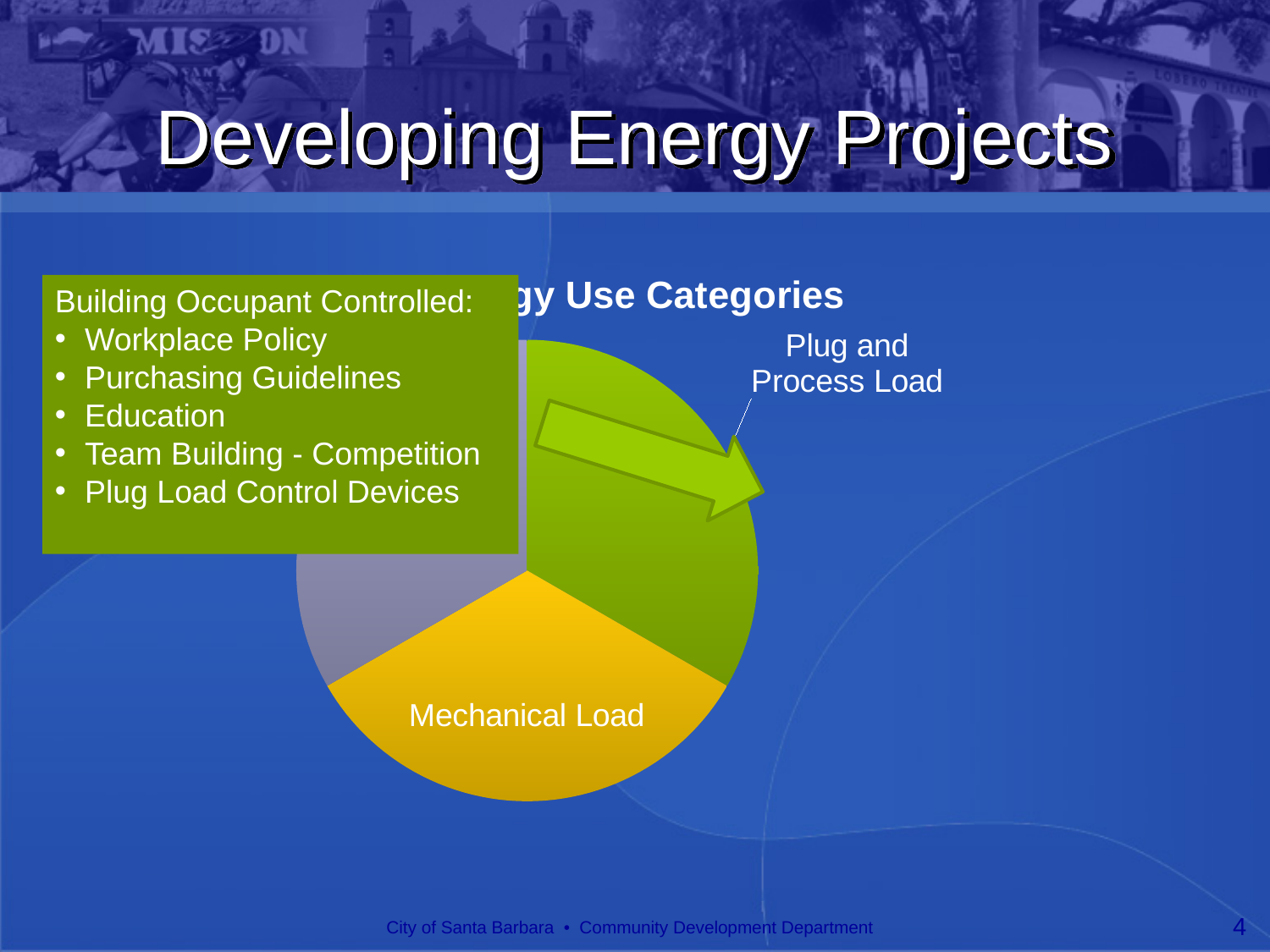
Which category label is shown on the yellow slice of the pie chart? Mechanical Load What colour is the Plug and Process Load slice of the pie chart? green What kind of chart is shown on the slide? pie chart Which slice is larger in the pie chart, Plug and Process Load or Mechanical Load? Neither; they are the same size How many slices does the pie chart have? 3